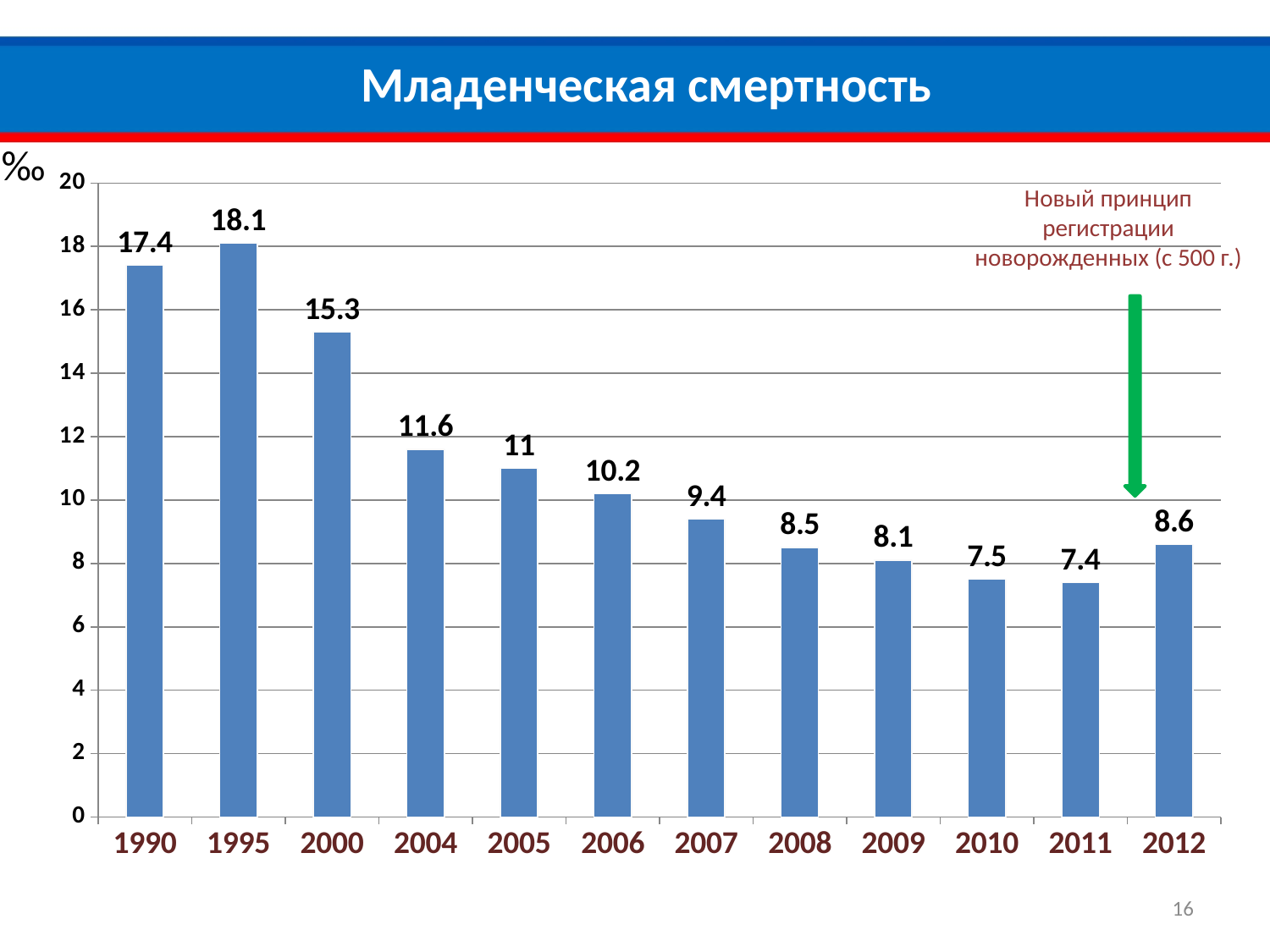
What is the difference between the values for 1995 and 2012? 9.5 How many years are shown on the x axis? 12 Do the values generally rise or fall from 1995 to 2011? fall Is the value for 2007 greater or less than 10? less Which year has the highest infant mortality value? 1995 Which is larger, the value for 2011 or the value for 2012? 2012 What is the value shown for 2006? 10.2 What is the value shown for 2012? 8.6 Which year has the lowest infant mortality value? 2011 What kind of chart is shown on the slide? bar chart What is the infant mortality value for 1990? 17.4 What is the difference between the values for 2000 and 2004? 3.7